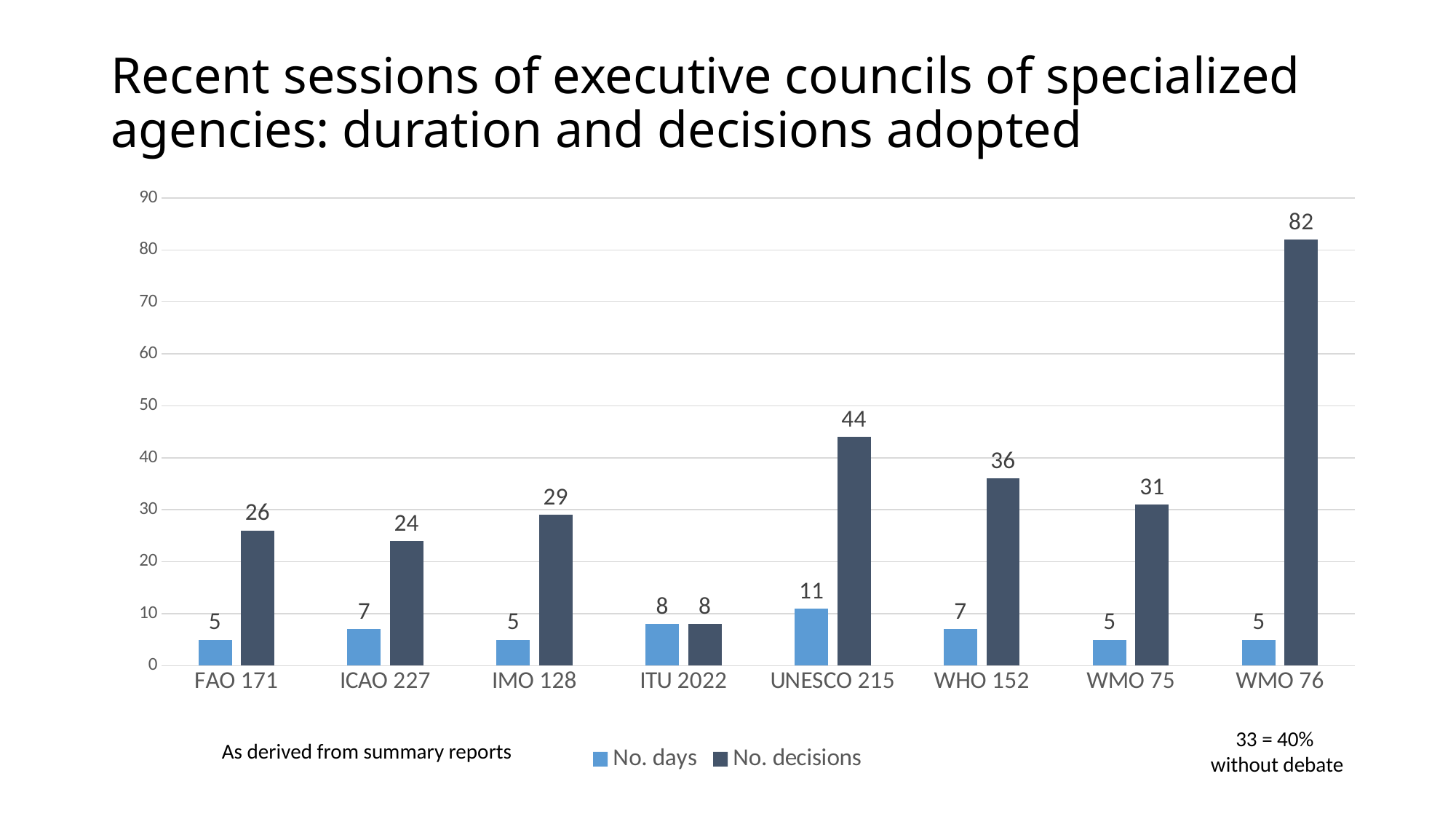
What is the number of decisions for WMO 76? 82 What is the number of decisions for ICAO 227? 24 Which session has the highest number of days? UNESCO 215 How many sessions are shown on the x axis? 8 What are the two series listed in the legend? No. days and No. decisions Which session has the lowest number of decisions? ITU 2022 How many series does the legend list? 2 What is the number of days for UNESCO 215? 11 Which is larger, the number of decisions for IMO 128 or for FAO 171? IMO 128 What kind of chart is shown on the slide? Bar chart Which session has the highest number of decisions? WMO 76 What is the difference between the number of decisions for WMO 76 and WHO 152? 46